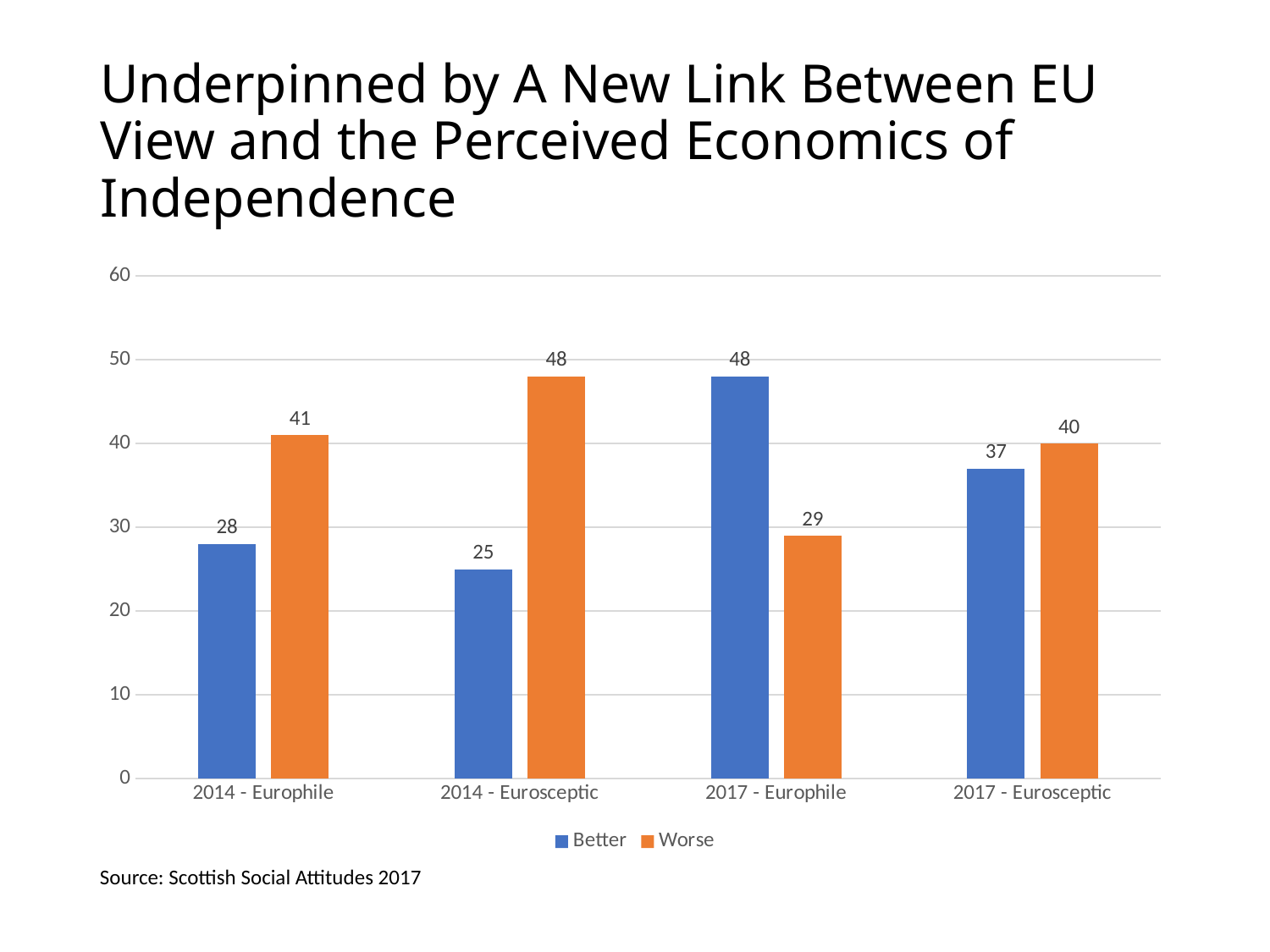
What source is cited below the chart? Scottish Social Attitudes 2017 In the 2017 - Eurosceptic category, which is larger, Better or Worse? Worse What is the value for Better in the 2014 - Europhile category? 28 Which category has the lowest value for Worse? 2017 - Europhile What kind of chart is shown on the slide? bar chart How many series does the legend list? 2 What is the value for Worse in the 2014 - Eurosceptic category? 48 Which category has the highest value for Better? 2017 - Europhile What is the difference between the Better and Worse values in the 2014 - Eurosceptic category? 23 How many categories are shown on the x axis? 4 What is the value for Better in the 2017 - Eurosceptic category? 37 Is the value for Worse in the 2017 - Europhile category greater or less than 30? less